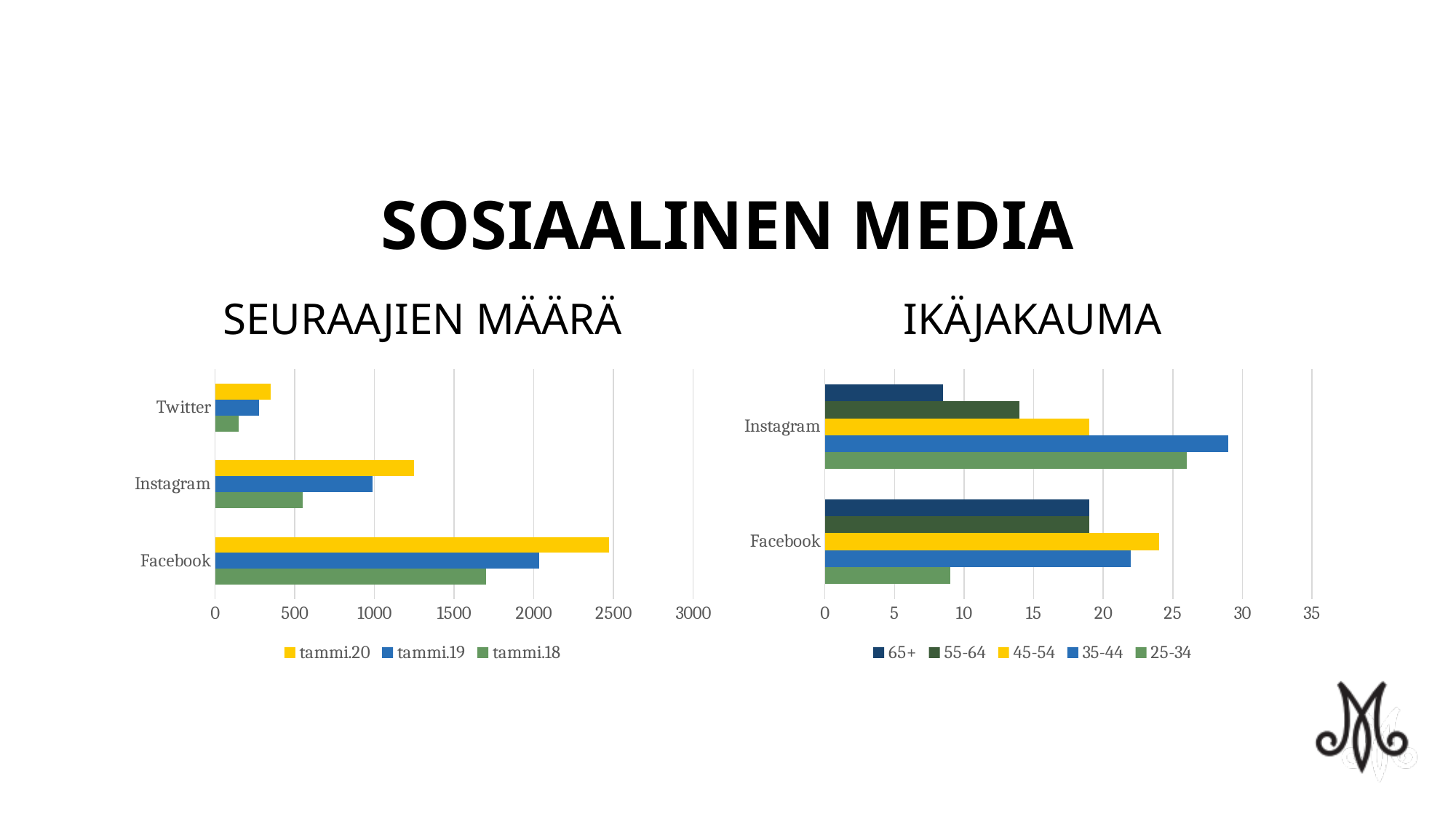
What kind of chart is the SEURAAJIEN MÄÄRÄ chart? bar chart How many series does the legend of the SEURAAJIEN MÄÄRÄ chart list? 3 In the SEURAAJIEN MÄÄRÄ chart, do the Facebook values rise or fall from tammi.18 to tammi.20? rise How many categories are shown on the SEURAAJIEN MÄÄRÄ chart? 3 In the SEURAAJIEN MÄÄRÄ chart, which category has the highest tammi.20 value? Facebook In the SEURAAJIEN MÄÄRÄ chart, which is larger for Instagram: tammi.20 or tammi.18? tammi.20 In the IKÄJAKAUMA chart, which age group has the lowest value for Facebook? 25-34 How many series does the legend of the IKÄJAKAUMA chart list? 5 In the IKÄJAKAUMA chart, is the 35-44 value for Instagram greater or less than 25? greater In the SEURAAJIEN MÄÄRÄ chart, is the tammi.20 value for Twitter greater or less than 500? less In the IKÄJAKAUMA chart, which age group has the highest value for Instagram? 35-44 In the SEURAAJIEN MÄÄRÄ chart, is the tammi.20 value for Instagram greater or less than 1000? greater